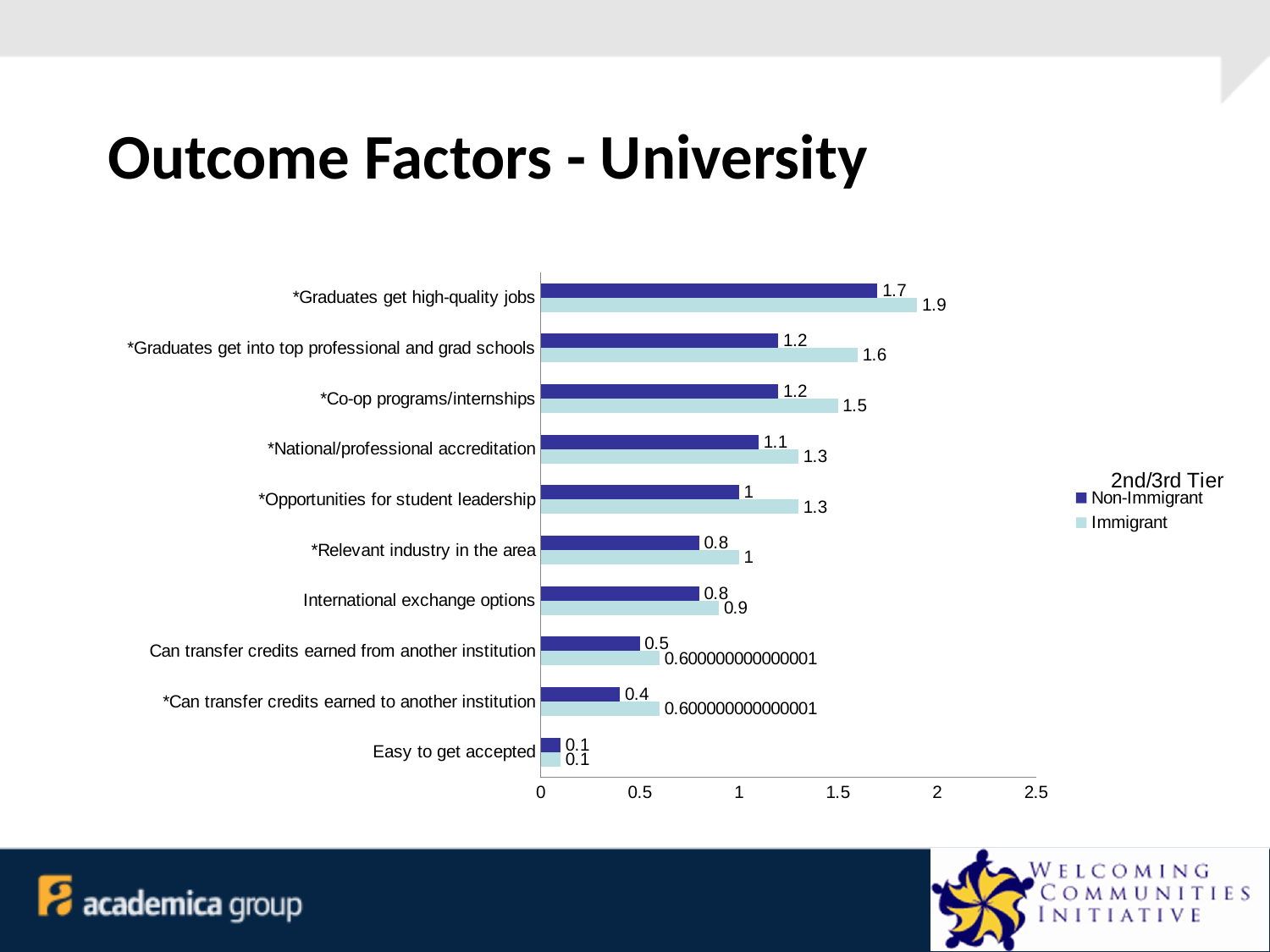
How many categories are shown on the chart? 10 What is the difference between the Immigrant and Non-Immigrant values for "*Graduates get into top professional and grad schools"? 0.4 What is the Immigrant value for "*Opportunities for student leadership"? 1.3 How many series does the legend list? 2 Which category has the lowest Immigrant value? Easy to get accepted What kind of chart is shown on the slide? Bar chart For "*National/professional accreditation", which is larger: the Immigrant value or the Non-Immigrant value? Immigrant What is the Non-Immigrant value for "*Can transfer credits earned to another institution"? 0.4 What is the Immigrant value for "*Graduates get high-quality jobs"? 1.9 What is the Non-Immigrant value for "*Co-op programs/internships"? 1.2 What is the title of the legend on the chart? 2nd/3rd Tier Which category has the highest Non-Immigrant value? *Graduates get high-quality jobs